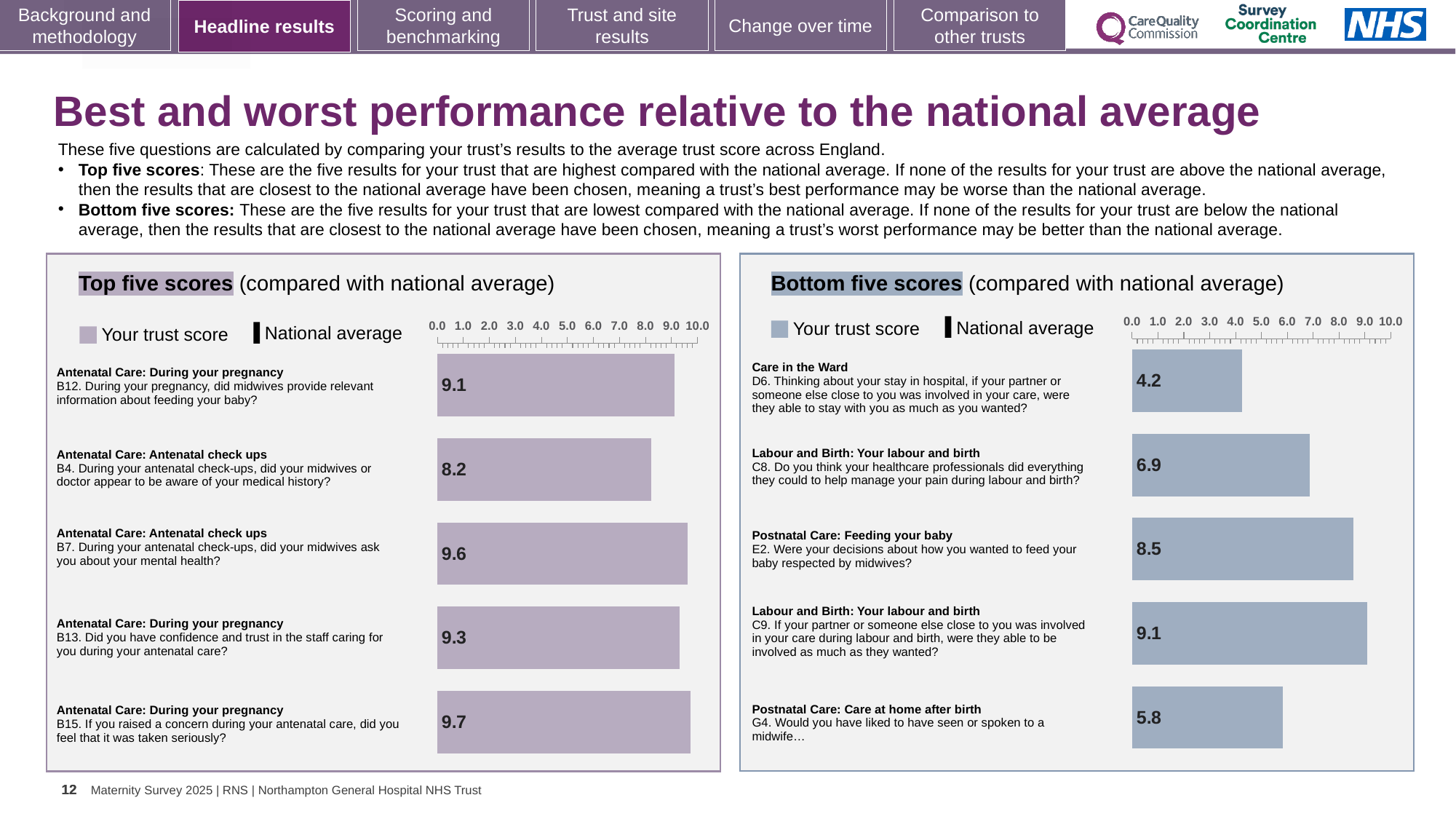
In the Bottom five scores chart, what is the trust score for G4 (would you have liked to have seen or spoken to a midwife)? 5.8 In the Bottom five scores chart, which has the larger trust score, C8 or E2? E2 What kind of chart is the Bottom five scores chart? bar chart In the Top five scores chart, what is the trust score for B7 (did your midwives ask you about your mental health)? 9.6 In the Top five scores chart, which question has the highest trust score? B15 (9.7) In the Bottom five scores chart, what is the difference between the scores for C9 and D6? 4.9 In the Top five scores chart, what is the difference between the scores for B15 and B4? 1.5 In the Top five scores chart, which question has the lowest trust score? B4 (8.2) In the Bottom five scores chart, which question has the lowest trust score? D6 (4.2) In the Bottom five scores chart, is the value for D6 greater or less than 5.0? less In the Bottom five scores chart, which question has the highest trust score? C9 (9.1) How many bars are plotted in the Top five scores chart? 5